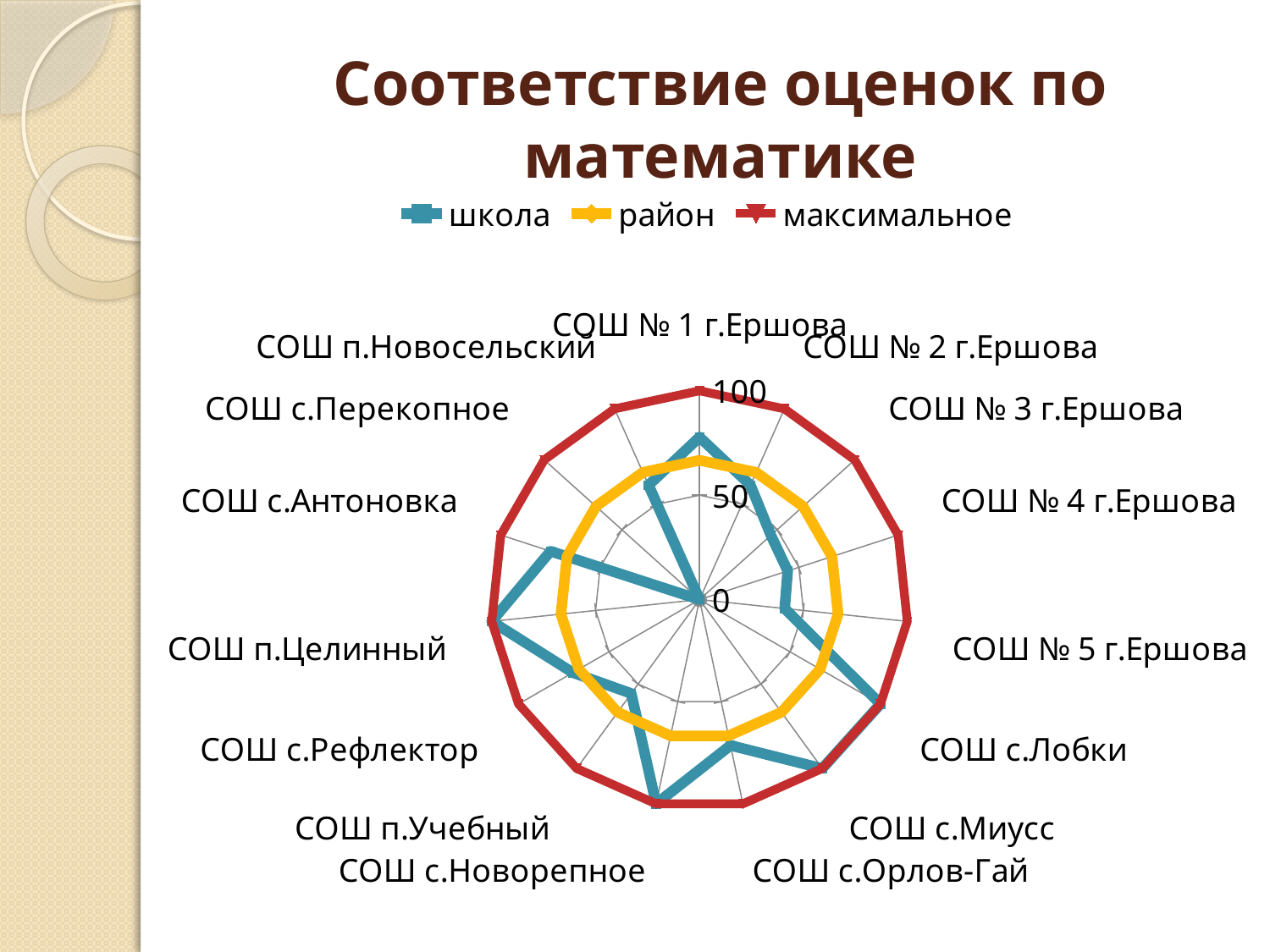
What kind of chart is shown on the slide? radar chart For СОШ № 5 г.Ершова, which is larger: the 'школа' value or the 'район' value? район For СОШ с.Лобки, which is larger: the 'школа' value or the 'район' value? школа Is the 'школа' value for СОШ № 1 г.Ершова greater or less than 50? greater What is the value of the 'максимальное' series for СОШ № 1 г.Ершова? 100 Is the 'школа' value for СОШ № 5 г.Ершова greater or less than 50? less How many schools (categories) are plotted on the chart? 15 Is the 'школа' value for СОШ п.Целинный greater or less than 50? greater How many series does the legend list? 3 What is the title of the chart? Соответствие оценок по математике Which colour represents the 'район' series in the legend? yellow